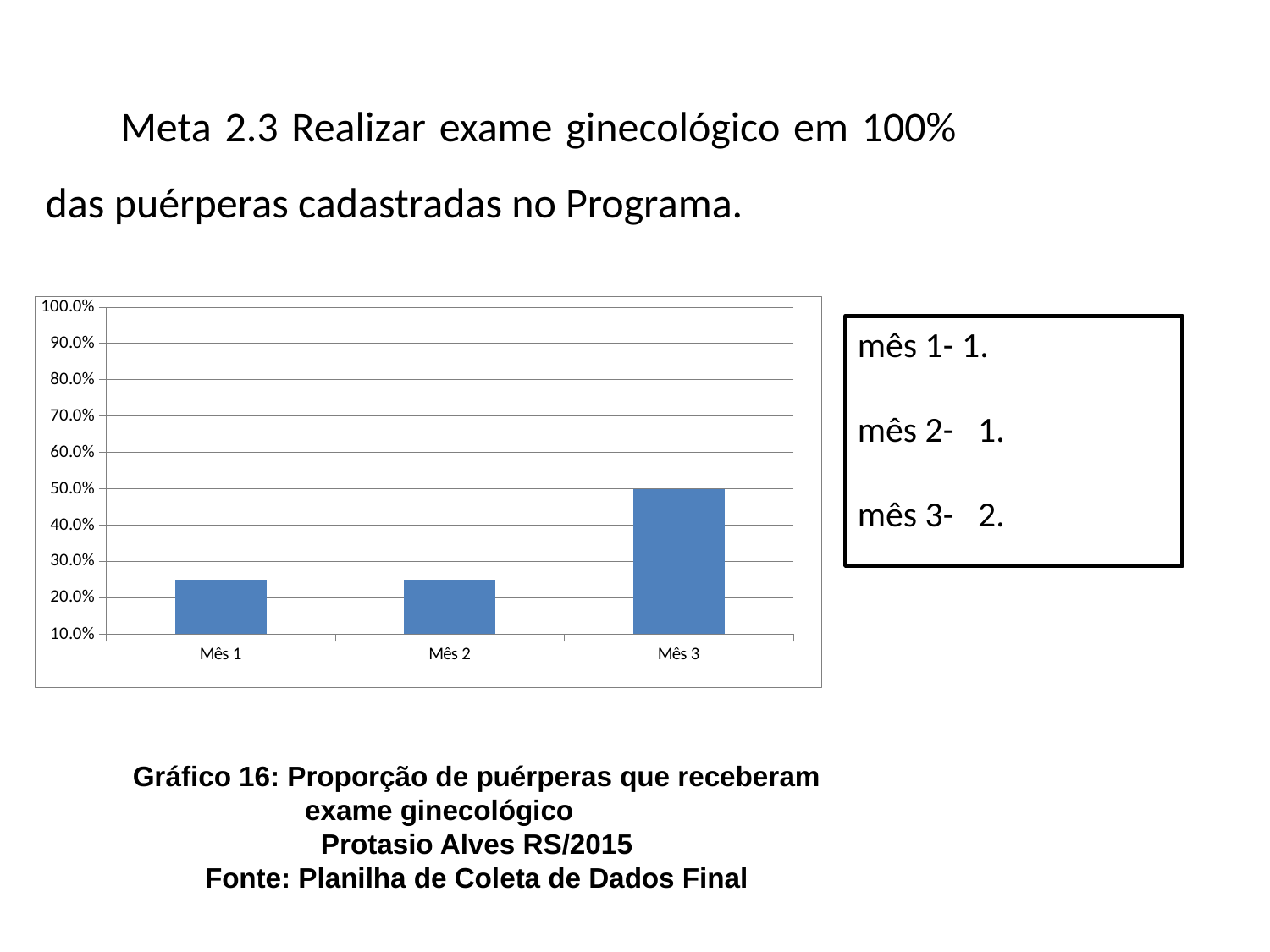
How many categories are plotted on the x axis of the chart? 3 What is the value for Mês 3 in the chart? 50.0% Is the value for Mês 2 greater or less than 30.0%? less Is the value for Mês 3 greater or less than 60.0%? less Do the values rise or fall from Mês 1 to Mês 3? rise What is the highest value shown on the vertical axis of the chart? 100.0% What type of chart is shown on the slide? bar chart Is the value for Mês 1 greater or less than 20.0%? greater What is the number of the graph given in the caption below the chart? Gráfico 16 Which month has the highest value in the chart? Mês 3 Which is larger, the value for Mês 1 or the value for Mês 3? Mês 3